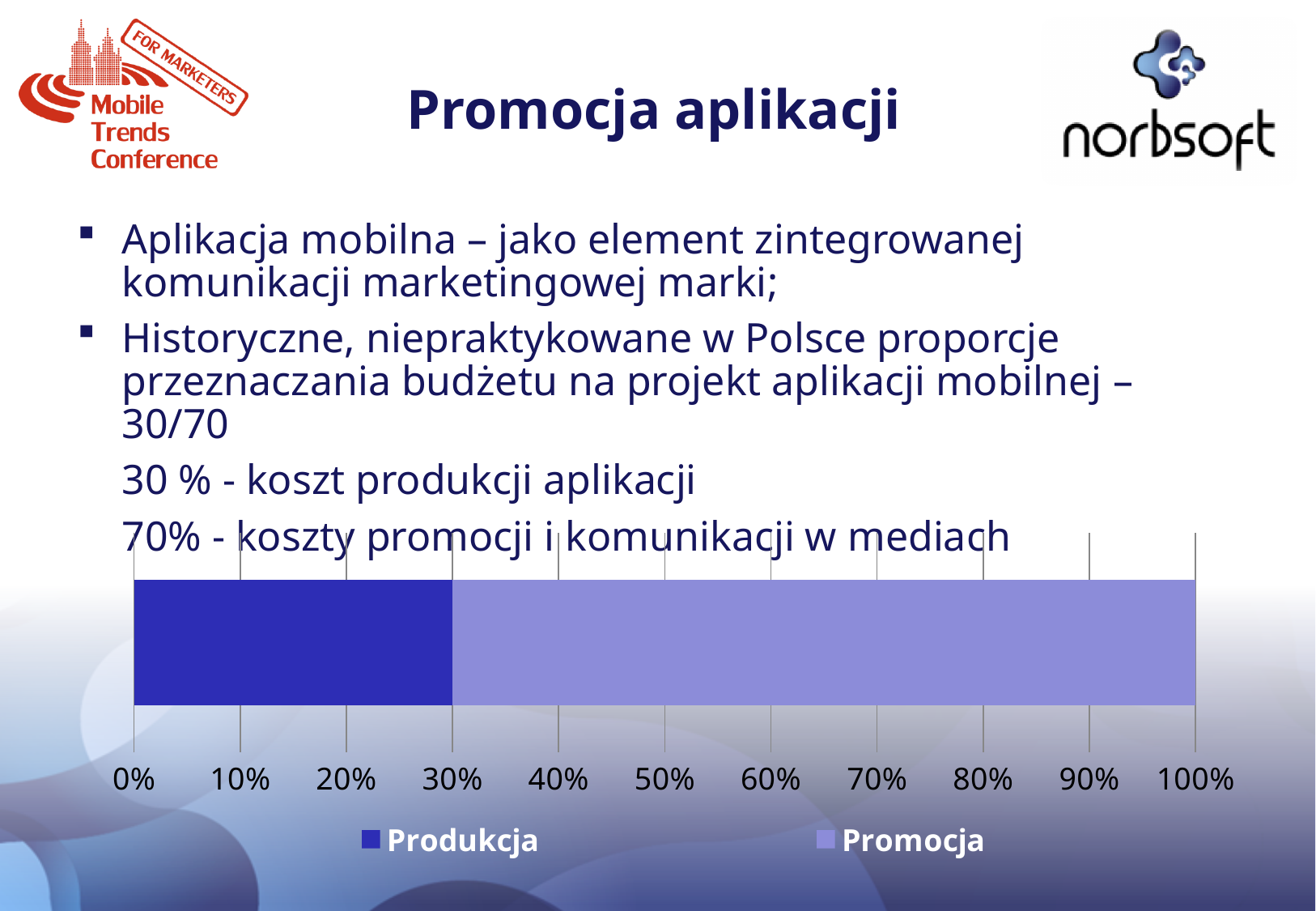
Which series takes the larger share of the bar, Produkcja or Promocja? Promocja What share of the bar does the Promocja segment take up? 70% Is the Promocja share greater or less than 60%? greater Is the Produkcja share greater or less than 50%? less What is the difference between the Promocja share and the Produkcja share? 40% How many series does the chart legend list? 2 What are the two series named in the chart legend? Produkcja and Promocja What is the highest value shown on the chart's percentage axis? 100% Which series has the largest share of the bar? Promocja What kind of chart is shown on the slide? bar chart Which series has the smallest share of the bar? Produkcja What share of the bar does the Produkcja segment take up? 30%